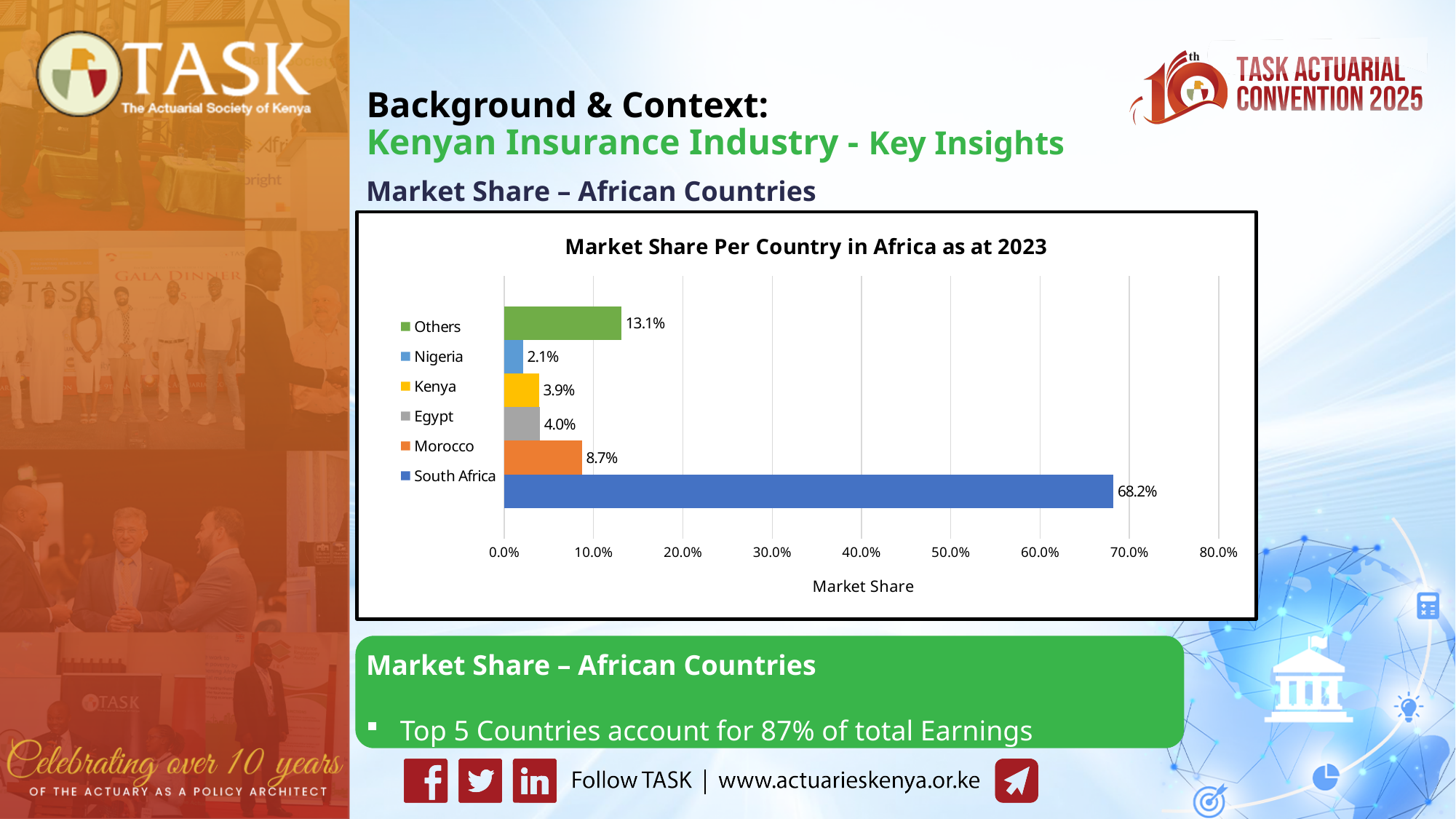
Is the value for South Africa greater or less than 60.0%? greater Which has a larger market share, Others or Morocco? Others What is the market share for South Africa? 68.2% What is the difference in market share between South Africa and Morocco? 59.5% What is the title of the chart? Market Share Per Country in Africa as at 2023 How many categories are shown in the chart? 6 What is the market share for Kenya? 3.9% Which category has the highest market share? South Africa What is the market share for Nigeria? 2.1% Which category has the lowest market share? Nigeria What kind of chart is shown on the slide? Bar chart What is the market share for Morocco? 8.7%